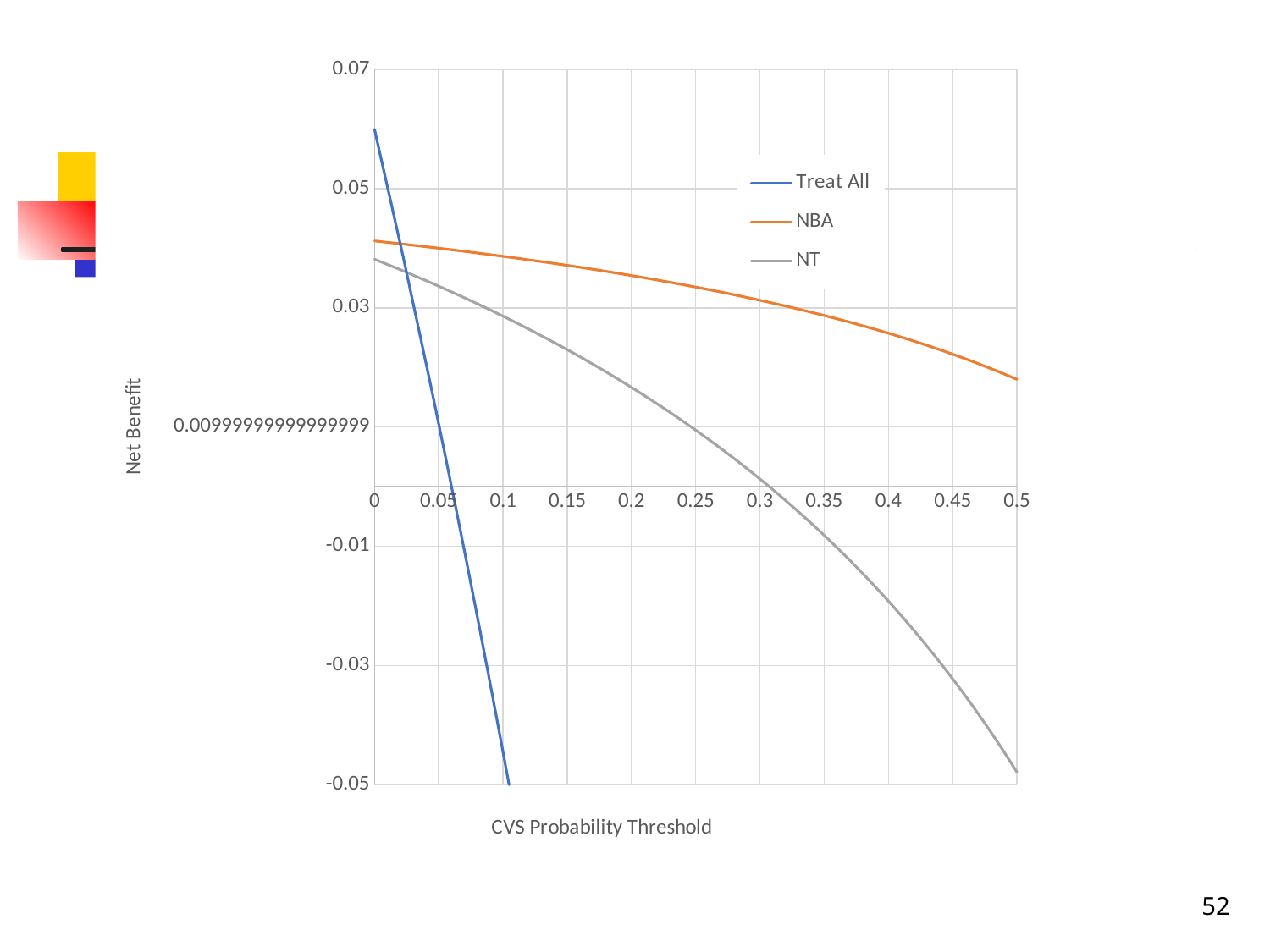
Does the NBA line rise or fall as the CVS Probability Threshold increases? fall Is the value of the NT line at a threshold of 0.4 greater or less than -0.01? less What is the title of the x axis? CVS Probability Threshold What kind of chart is shown on the slide? line chart Does the Treat All line rise or fall as the CVS Probability Threshold increases? fall Is the value of the Treat All line at a threshold of 0 greater or less than 0.05? greater At a threshold of 0.5, which line has the higher net benefit, NBA or NT? NBA At a threshold of 0, which line has the higher net benefit, Treat All or NBA? Treat All What are the series names listed in the legend? Treat All, NBA, NT Is the value of the NBA line at a threshold of 0.5 greater or less than 0.01? greater How many series does the legend list? 3